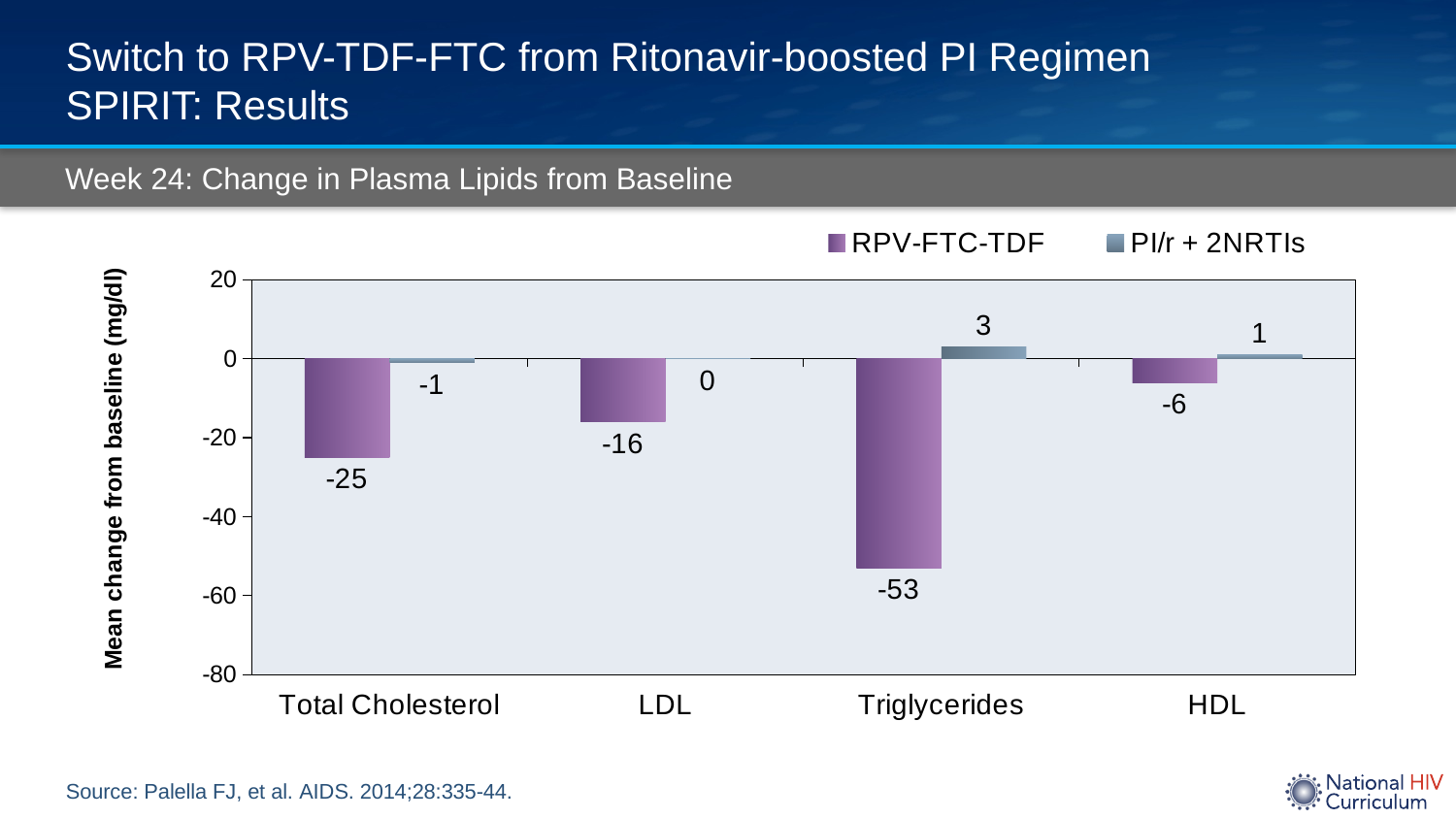
Which group has the larger decrease in LDL, RPV-FTC-TDF or PI/r + 2NRTIs? RPV-FTC-TDF How many series does the legend list? 2 What kind of chart is shown on the slide? Bar chart What is the mean change from baseline in HDL for the RPV-FTC-TDF group? -6 What is the mean change from baseline in LDL for the PI/r + 2NRTIs group? 0 Which lipid category shows the largest decrease for the RPV-FTC-TDF group? Triglycerides How many lipid categories are shown on the x axis? 4 What is the difference between the RPV-FTC-TDF and PI/r + 2NRTIs values for Triglycerides? 56 Which lipid category shows the smallest change for the RPV-FTC-TDF group? HDL What is the mean change from baseline in Triglycerides for the PI/r + 2NRTIs group? 3 What is the difference between the RPV-FTC-TDF and PI/r + 2NRTIs values for Total Cholesterol? 24 What is the mean change from baseline in Total Cholesterol for the RPV-FTC-TDF group? -25